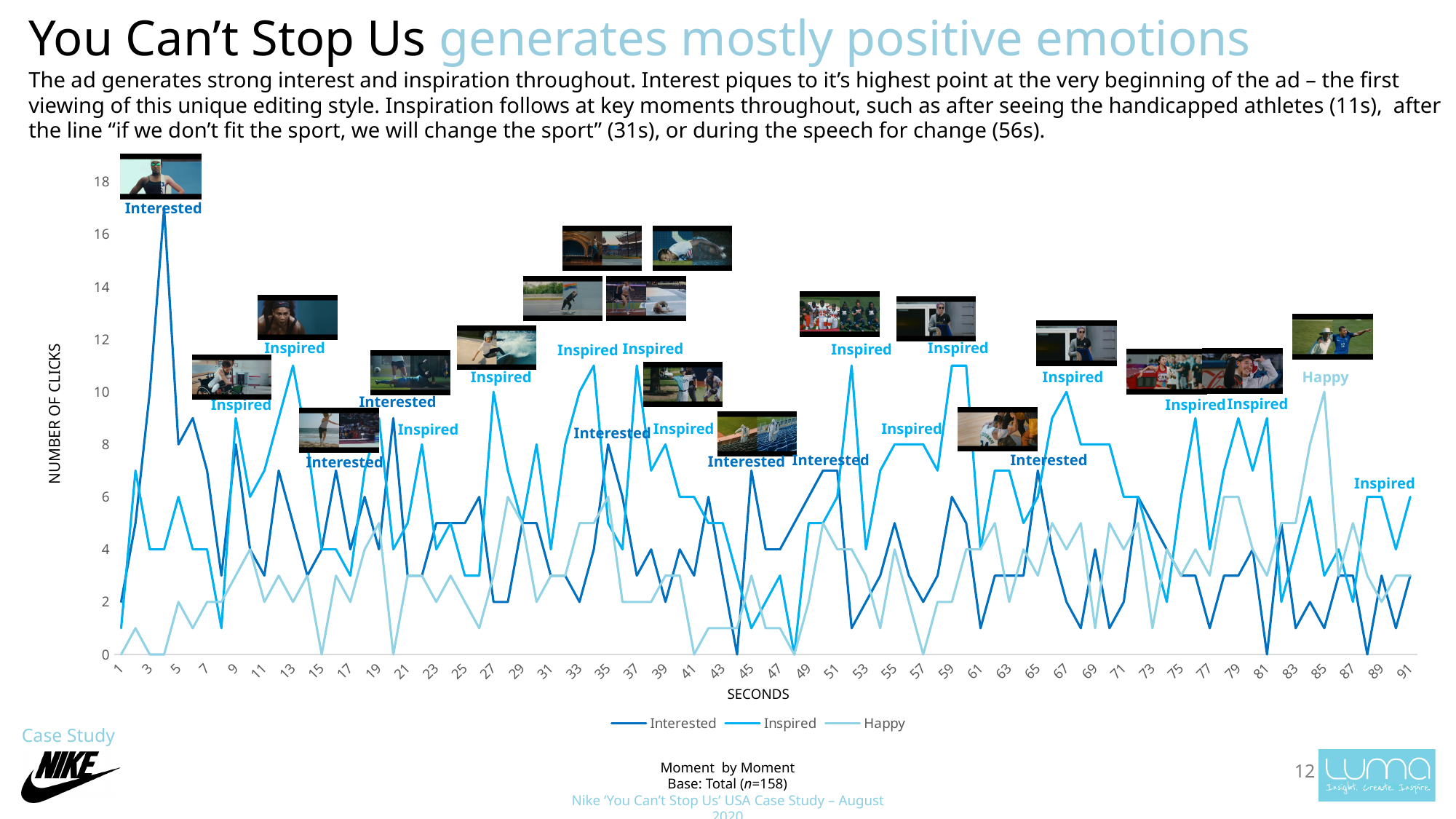
What are the three series named in the chart's legend? Interested, Inspired, Happy At second 85, which series has the larger value, Happy or Interested? Happy Is the Interested value at second 1 greater or less than 4? less What is the title of the chart's vertical axis? NUMBER OF CLICKS Is the Happy value at second 85 greater or less than 8? greater Is the Inspired value at second 4 greater or less than 8? less Which series reaches the highest value anywhere on the chart? Interested Does the Interested line generally rise or fall from its peak near second 4 to the end of the ad at second 91? fall At second 4, which series has the larger value, Interested or Inspired? Interested What kind of chart is shown on the slide? line chart How many series does the chart's legend list? 3